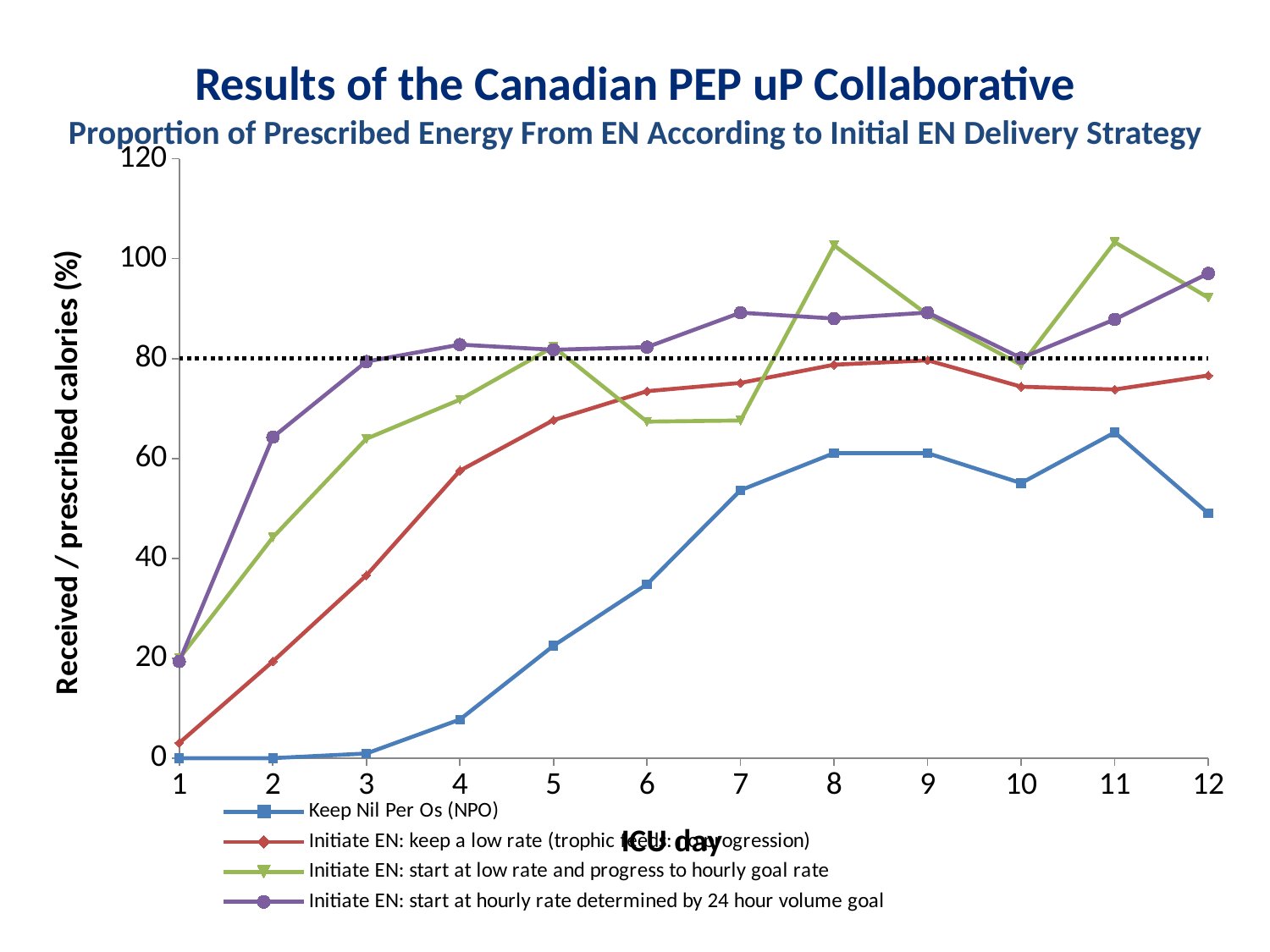
How many series does the legend list? 4 How many ICU days are plotted along the x axis? 12 Does the Keep Nil Per Os (NPO) series rise or fall from ICU day 1 to ICU day 8? rise Which series has the lowest value on ICU day 5? Keep Nil Per Os (NPO) Is the value for Keep Nil Per Os (NPO) on ICU day 12 greater or less than 60? less On which ICU day is the value for 'Initiate EN: keep a low rate (trophic feeds)' lowest? 1 Is the value for 'Initiate EN: start at low rate and progress to hourly goal rate' on ICU day 8 greater or less than 100? greater On ICU day 6, which is larger: the value for 'Initiate EN: keep a low rate (trophic feeds)' or the value for 'Initiate EN: start at low rate and progress to hourly goal rate'? Initiate EN: keep a low rate (trophic feeds) What kind of chart is shown on the slide? line chart At what value on the y axis is the dotted horizontal reference line drawn? 80 Is the value for 'Initiate EN: start at hourly rate determined by 24 hour volume goal' on ICU day 7 greater or less than 80? greater